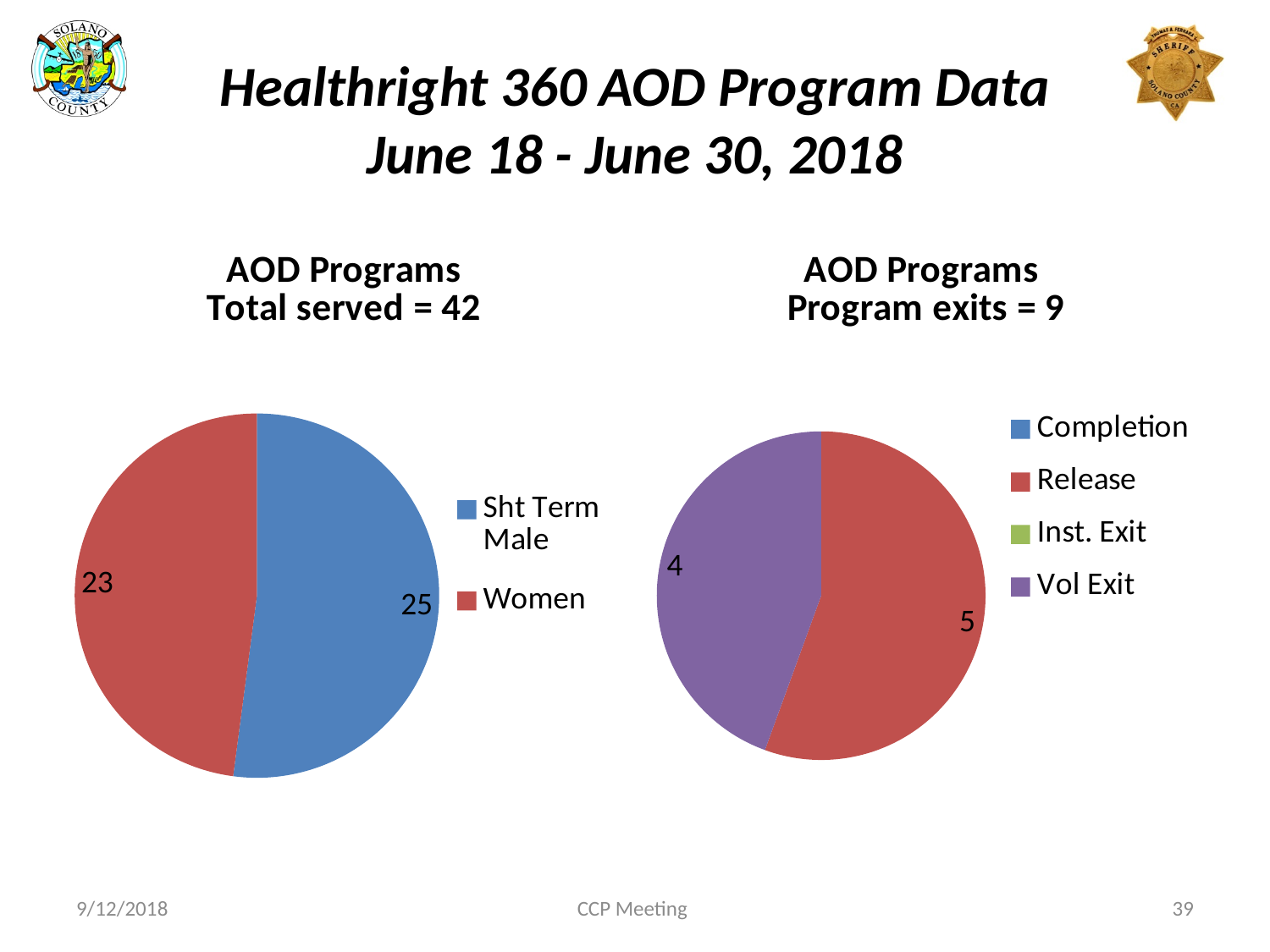
In the 'AOD Programs Program exits = 9' chart, which is larger, Release or Vol Exit? Release What kind of chart is the 'AOD Programs Total served = 42' chart? Pie chart In the 'AOD Programs Total served = 42' chart, what is the value for Sht Term Male? 25 How many entries does the legend of the 'AOD Programs Total served = 42' chart list? 2 In the 'AOD Programs Program exits = 9' chart, what is the value for Vol Exit? 4 In the 'AOD Programs Total served = 42' chart, what is the value for Women? 23 In the 'AOD Programs Total served = 42' chart, what is the difference between Sht Term Male and Women? 2 In the 'AOD Programs Total served = 42' chart, which category has the larger value? Sht Term Male How many entries does the legend of the 'AOD Programs Program exits = 9' chart list? 4 In the 'AOD Programs Program exits = 9' chart, what colour is the Vol Exit slice? Purple In the 'AOD Programs Program exits = 9' chart, what is the difference between Release and Vol Exit? 1 In the 'AOD Programs Program exits = 9' chart, what is the value for Release? 5